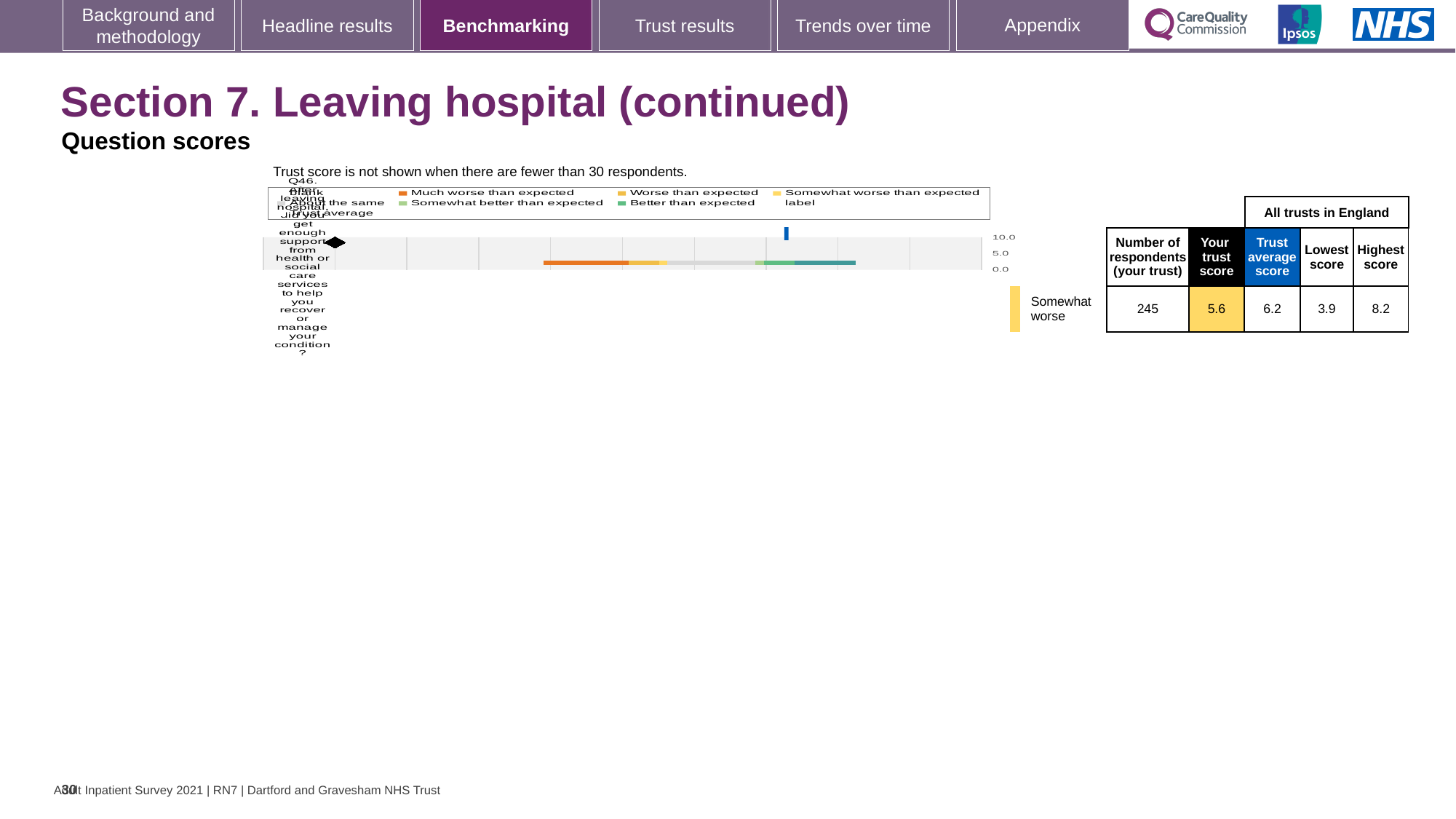
How many respondents from the trust answered Q46? 245 What is the trust average score for Q46 across all trusts in England? 6.2 What is the maximum value shown on the chart's score axis? 10.0 What benchmark category is the trust's Q46 score given on the slide? Somewhat worse What is the difference between the trust average score and your trust score for Q46? 0.6 What is the trust score for Q46 shown on the slide? 5.6 What is the lowest score among all trusts in England for Q46? 3.9 What is the difference between the highest score and the lowest score for Q46 across all trusts in England? 4.3 Is the trust score for Q46 greater or less than 5.0 on the chart axis? greater What is the highest score among all trusts in England for Q46? 8.2 Which is larger for Q46: your trust score or the trust average score? Trust average score How many questions are plotted on the chart? 1